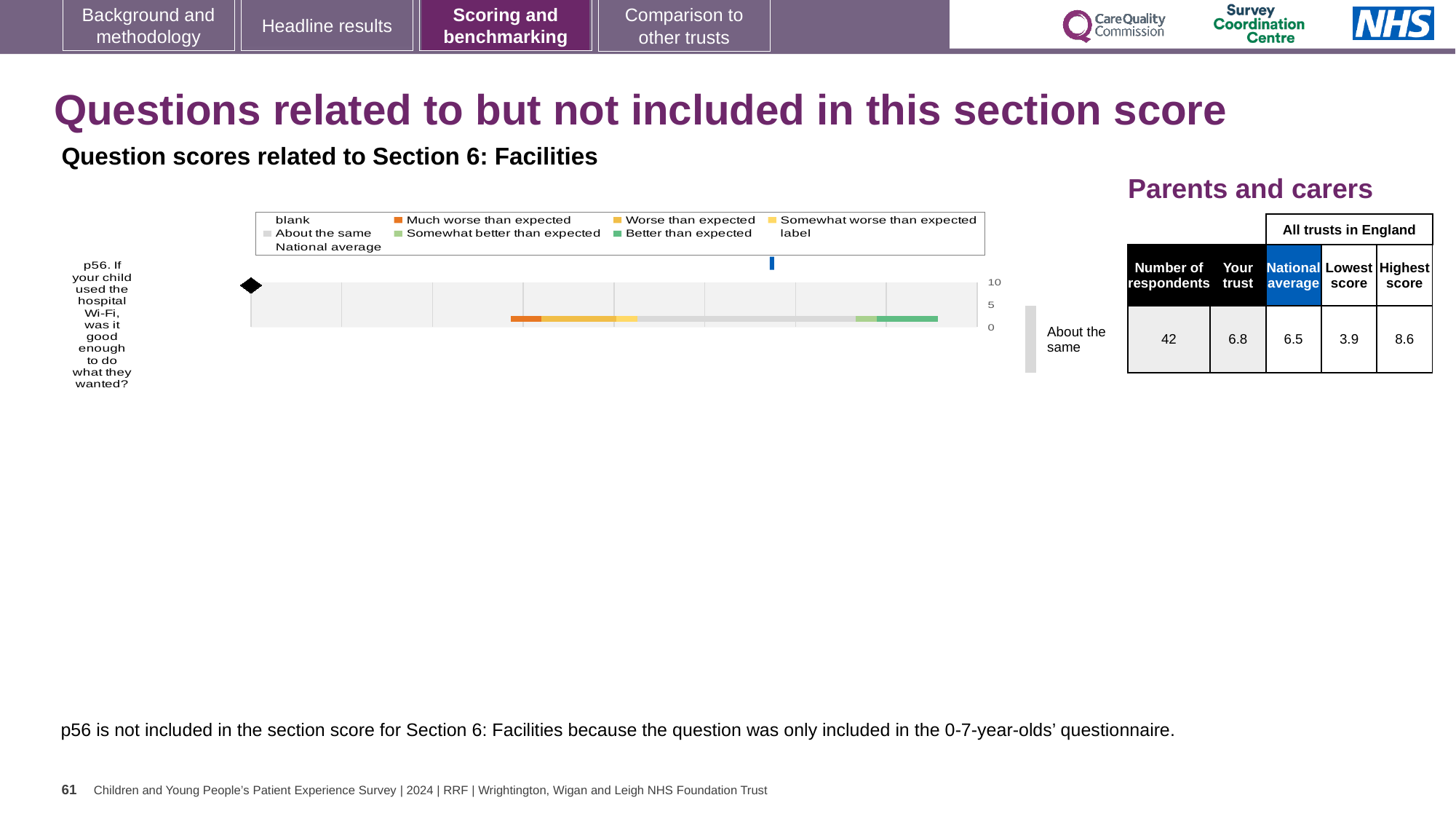
For p56, what is the difference between the 'Your trust' score and the national average? 0.3 According to the table beside the chart, what is the national average score for p56? 6.5 According to the table beside the chart, what is the lowest score among all trusts in England for p56? 3.9 Which colour in the legend represents 'Much worse than expected'? orange According to the table beside the chart, what is the highest score among all trusts in England for p56? 8.6 For p56, what is the difference between the highest score and the lowest score among all trusts in England? 4.7 For p56, which is larger: the 'Your trust' score or the national average? Your trust What kind of chart is shown on the slide? bar chart What is the highest value shown on the chart's score axis? 10 According to the table beside the chart, how many respondents answered p56? 42 According to the table beside the chart, what is the 'Your trust' score for p56? 6.8 How many survey questions are plotted in the chart? 1